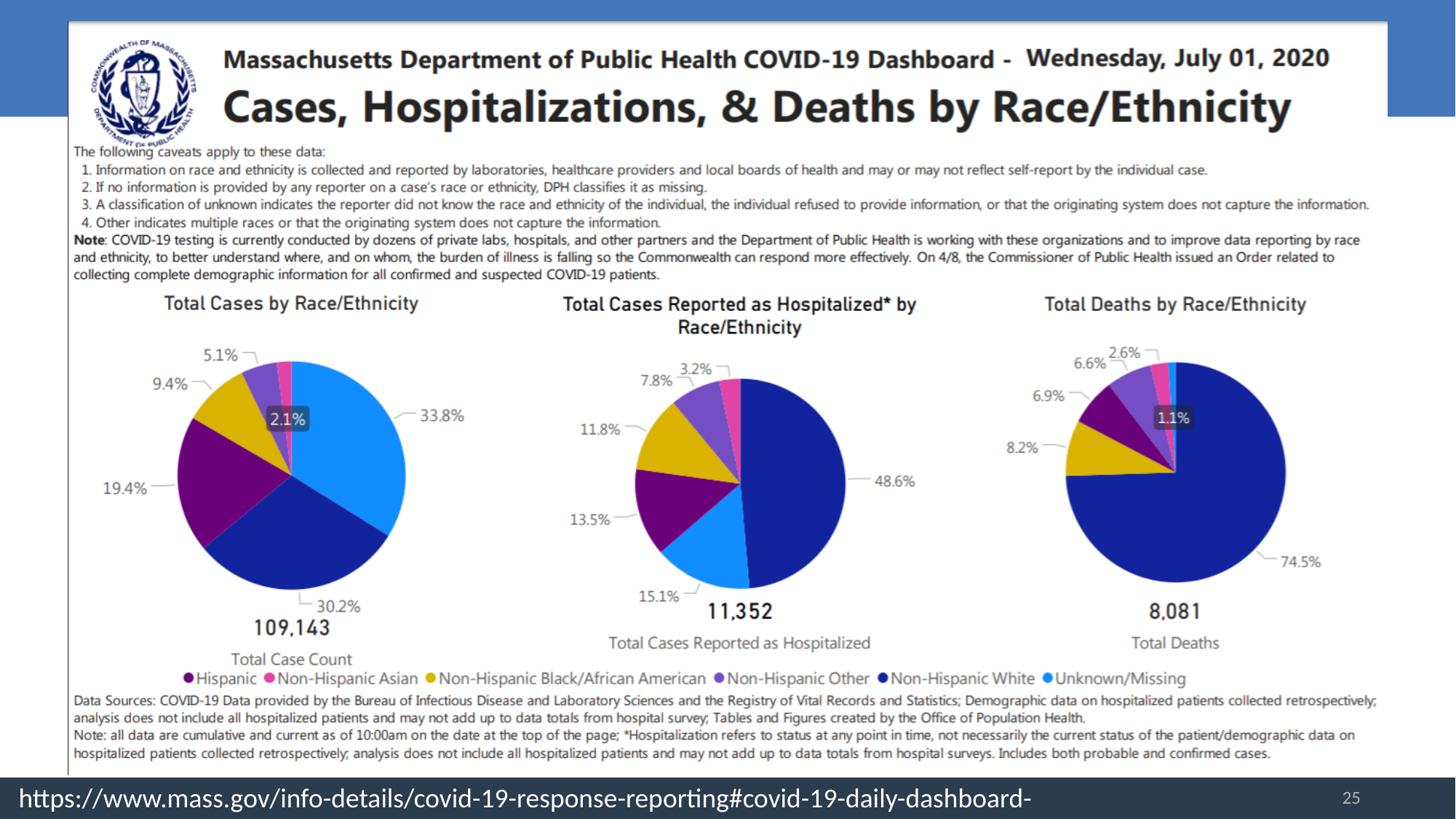
What is the Total Case Count shown under the Total Cases by Race/Ethnicity chart? 109,143 In the Total Cases Reported as Hospitalized by Race/Ethnicity chart, which is larger: the Hispanic share or the Non-Hispanic Black/African American share? Hispanic In the Total Deaths by Race/Ethnicity chart, which category has the smallest share? Unknown/Missing In the Total Cases by Race/Ethnicity chart, what share of cases is Unknown/Missing? 33.8% In the Total Deaths by Race/Ethnicity chart, what share of deaths is Non-Hispanic Black/African American? 8.2% In the Total Cases Reported as Hospitalized by Race/Ethnicity chart, what share is Non-Hispanic White? 48.6% In the Total Deaths by Race/Ethnicity chart, which category has the largest share? Non-Hispanic White How many categories does the shared legend list for the pie charts? 6 What is the Total Deaths figure shown under the Total Deaths by Race/Ethnicity chart? 8,081 In the Total Cases by Race/Ethnicity chart, what is the difference between the Unknown/Missing share and the Non-Hispanic White share? 3.6% What kind of chart is the Total Deaths by Race/Ethnicity chart? Pie chart